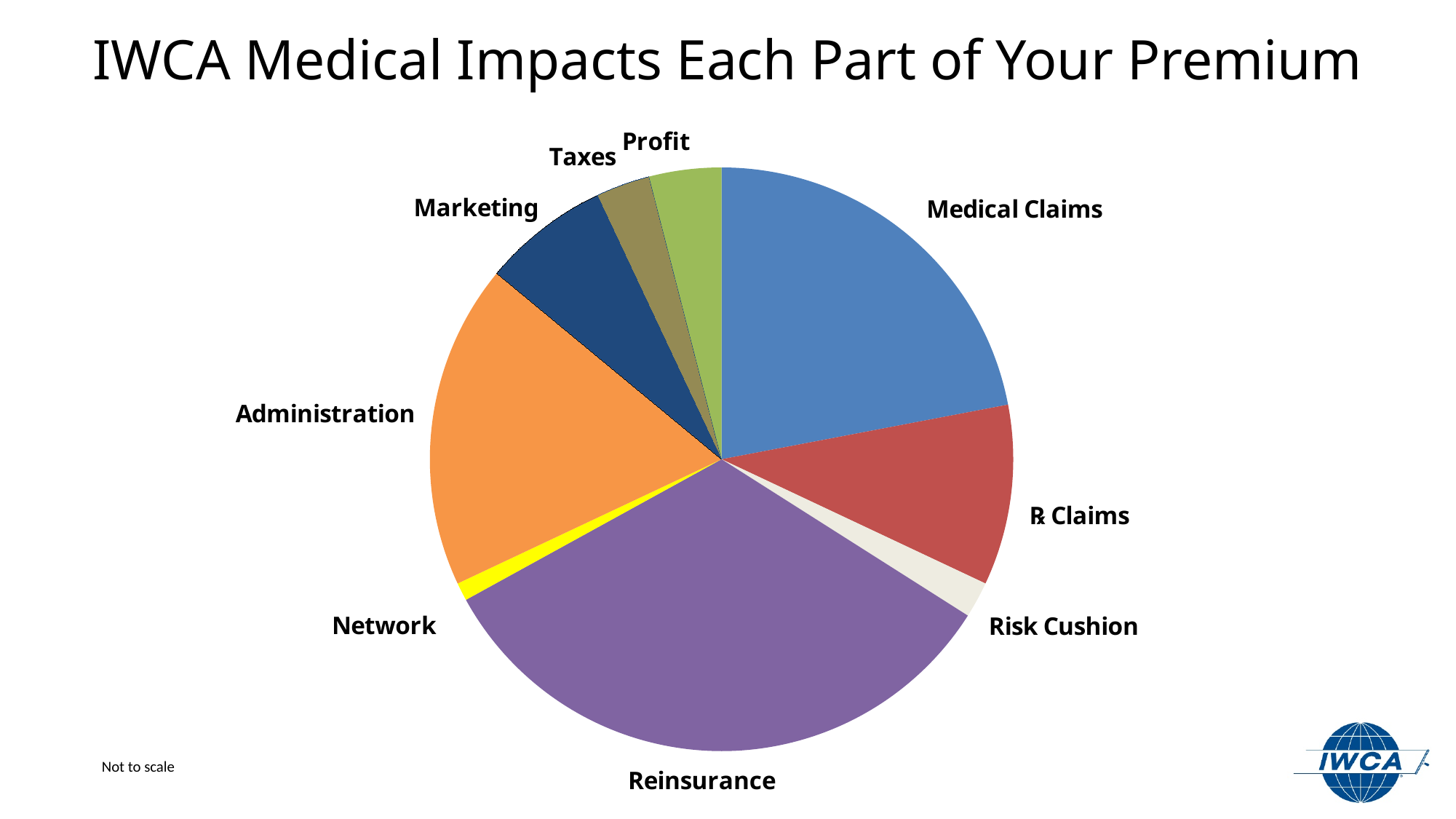
What is the title of the chart on the slide? IWCA Medical Impacts Each Part of Your Premium What colour is the Reinsurance slice? Purple What kind of chart is shown on the slide? Pie chart Which slice is larger, Reinsurance or Medical Claims? Reinsurance How many slices does the pie chart have? 9 Which slice is larger, Administration or Marketing? Administration Which slice is larger, Medical Claims or Administration? Medical Claims Which category has the largest slice of the pie? Reinsurance